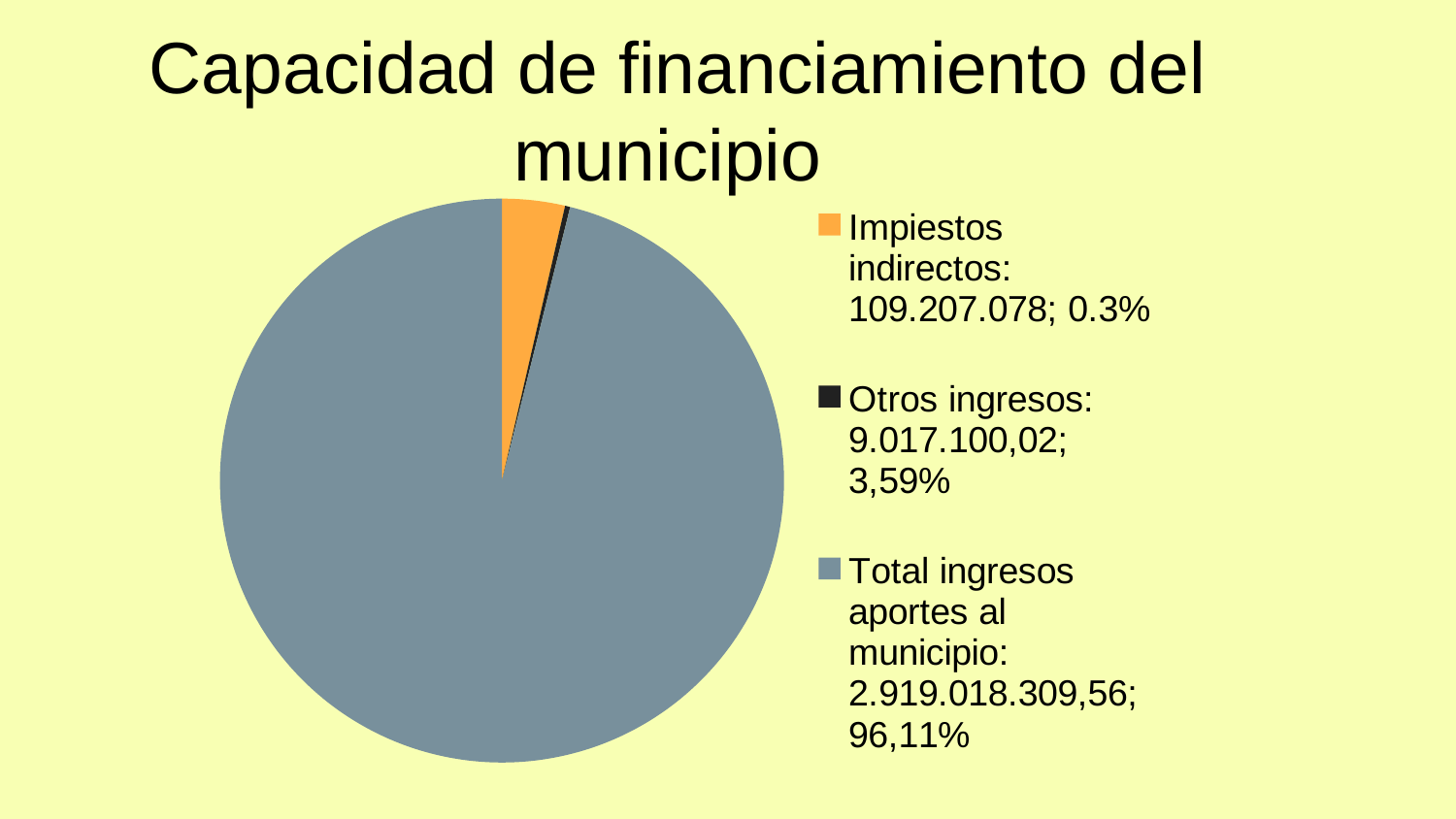
What share of the pie does Total ingresos aportes al municipio represent? 96,11% Which is larger, the value for Total ingresos aportes al municipio or the value for Otros ingresos? Total ingresos aportes al municipio What is the title of the slide? Capacidad de financiamiento del municipio Which category has the largest slice of the pie? Total ingresos aportes al municipio What share of the pie does Otros ingresos represent? 3,59% What kind of chart is shown on the slide? Pie chart How many categories does the pie chart have? 3 What value is shown for Impiestos indirectos? 109.207.078 What share of the pie does Impiestos indirectos represent? 0.3% What value is shown for Otros ingresos? 9.017.100,02 What colour is the slice for Impiestos indirectos? Orange What value is shown for Total ingresos aportes al municipio? 2.919.018.309,56